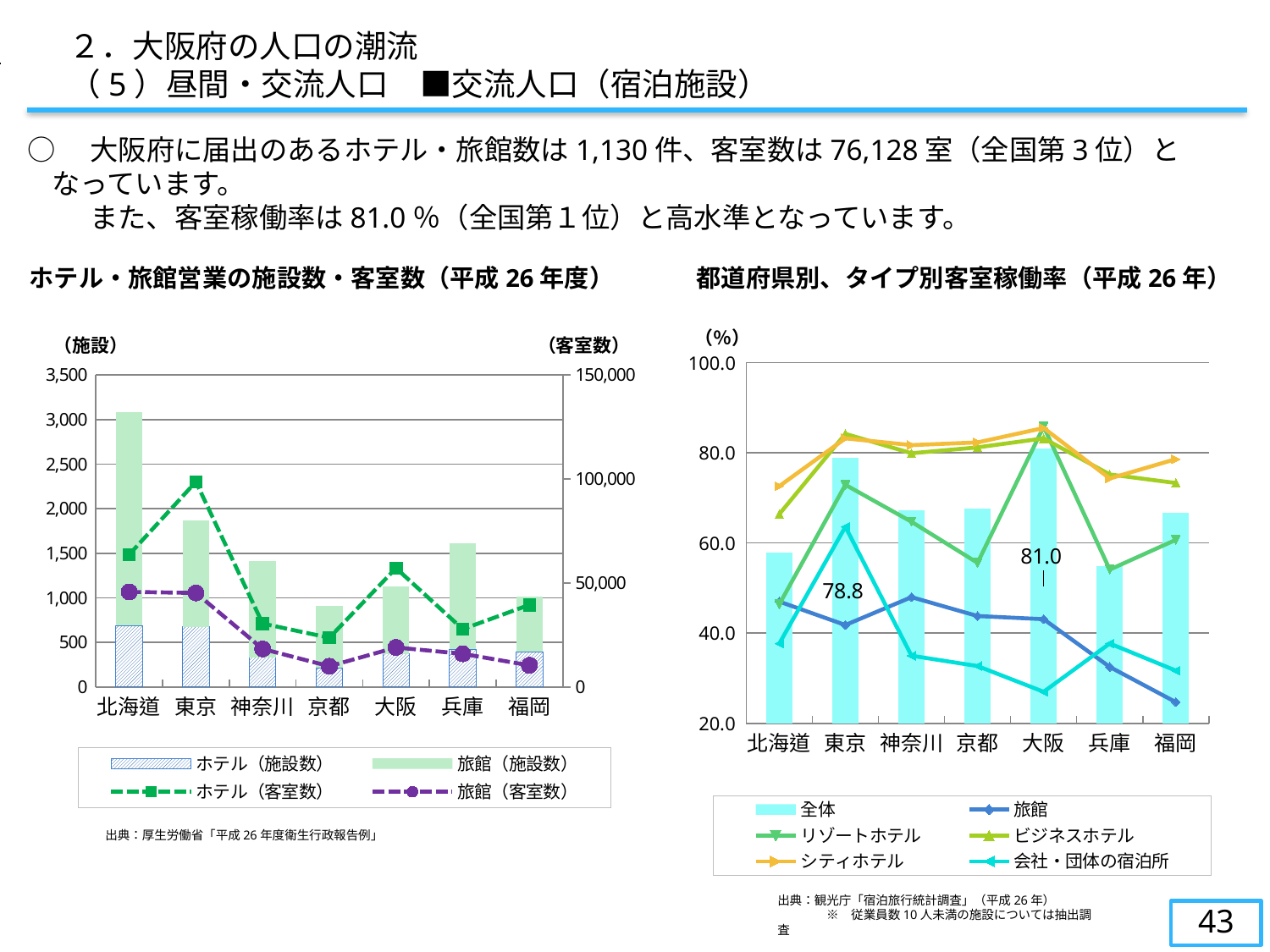
In the chart ホテル・旅館営業の施設数・客室数（平成26年度）, what kind of chart is it? Combination bar and line chart In the chart 都道府県別、タイプ別客室稼働率（平成26年）, how many prefectures are shown on the x axis? 7 In the chart 都道府県別、タイプ別客室稼働率（平成26年）, which prefecture has the highest 全体 occupancy rate? 大阪 In the chart 都道府県別、タイプ別客室稼働率（平成26年）, what is the 全体 occupancy rate for 東京? 78.8 In the chart ホテル・旅館営業の施設数・客室数（平成26年度）, which prefecture has the highest 旅館（施設数）? 北海道 In the chart 都道府県別、タイプ別客室稼働率（平成26年）, is the 旅館 value for 福岡 greater or less than 40.0? less In the chart ホテル・旅館営業の施設数・客室数（平成26年度）, is the ホテル（客室数） value for 東京 greater or less than 50,000? greater In the chart 都道府県別、タイプ別客室稼働率（平成26年）, what is the difference between the 全体 values for 大阪 and 東京? 2.2 In the chart ホテル・旅館営業の施設数・客室数（平成26年度）, which prefecture has the highest ホテル（客室数）? 東京 In the chart 都道府県別、タイプ別客室稼働率（平成26年）, how many series does the legend list? 6 In the chart ホテル・旅館営業の施設数・客室数（平成26年度）, how many series does the legend list? 4 In the chart 都道府県別、タイプ別客室稼働率（平成26年）, what is the 全体 occupancy rate for 大阪? 81.0